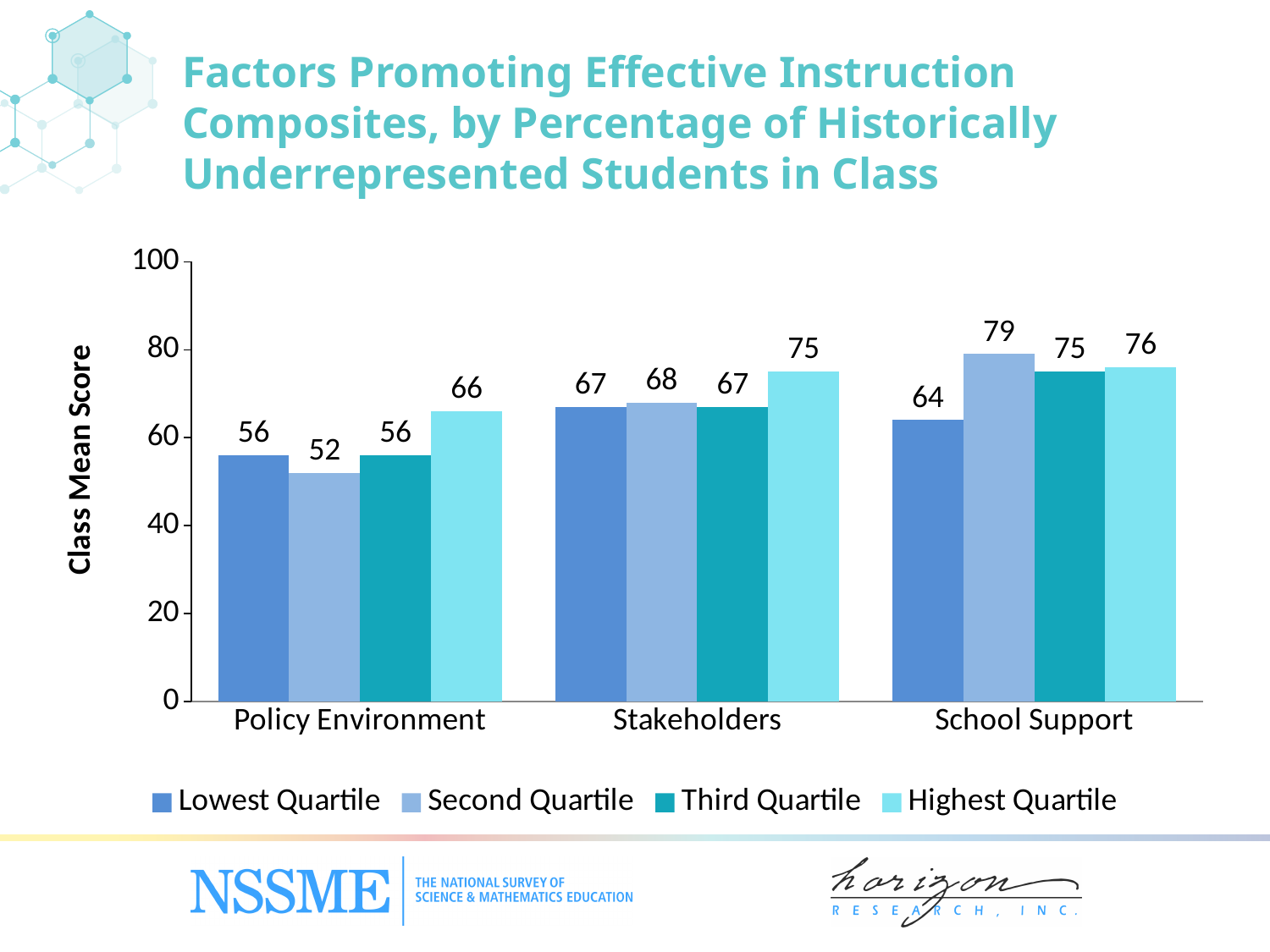
How many categories are shown on the x axis? 3 What is the class mean score for the Lowest Quartile in the Stakeholders category? 67 Is the Lowest Quartile score for School Support greater or less than 60? greater Which quartile has the highest class mean score in the School Support category? Second Quartile What is the difference between the Highest Quartile and Second Quartile scores in the Policy Environment category? 14 What kind of chart is shown on the slide? Bar chart Which quartile has the lowest class mean score in the Policy Environment category? Second Quartile What is the label of the y axis? Class Mean Score What is the class mean score for the Highest Quartile in the Policy Environment category? 66 What is the class mean score for the Second Quartile in the School Support category? 79 Which is larger: the Highest Quartile score for Stakeholders or the Highest Quartile score for School Support? School Support How many series does the legend list? 4